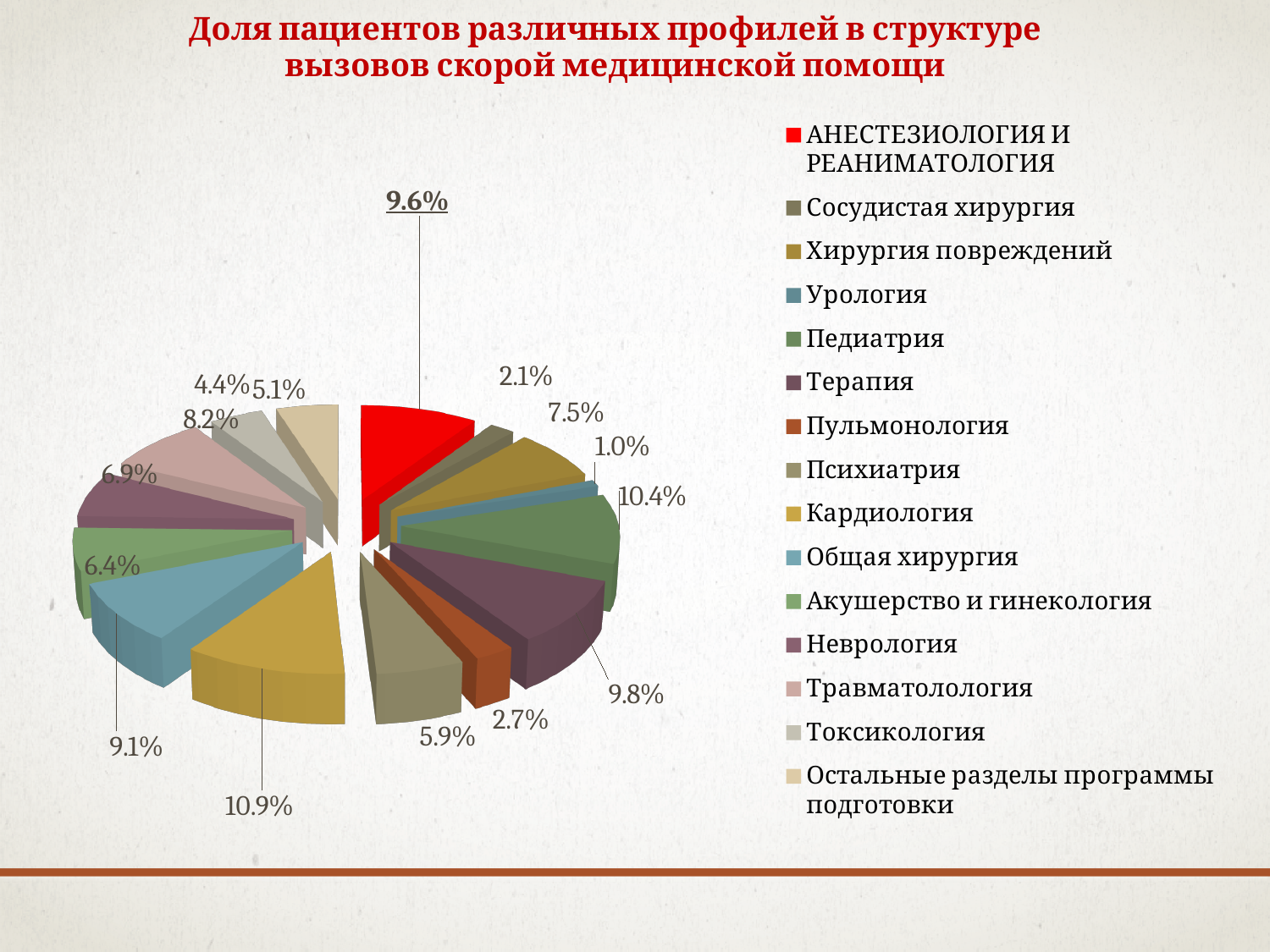
What colour is the АНЕСТЕЗИОЛОГИЯ И РЕАНИМАТОЛОГИЯ slice? Red What share does the Кардиология slice have? 10.9% What share does the АНЕСТЕЗИОЛОГИЯ И РЕАНИМАТОЛОГИЯ slice have? 9.6% How many entries does the legend list? 15 What share does the Педиатрия slice have? 10.4% Which category has the smallest share of the pie? Урология How many categories are shown in the pie chart? 15 What kind of chart is shown on the slide? Pie chart What share does the Урология slice have? 1.0% Which category has the largest share of the pie? Кардиология Which has a larger share, Травматология or Токсикология? Травматология What is the difference between the shares of Терапия and Пульмонология? 7.1%